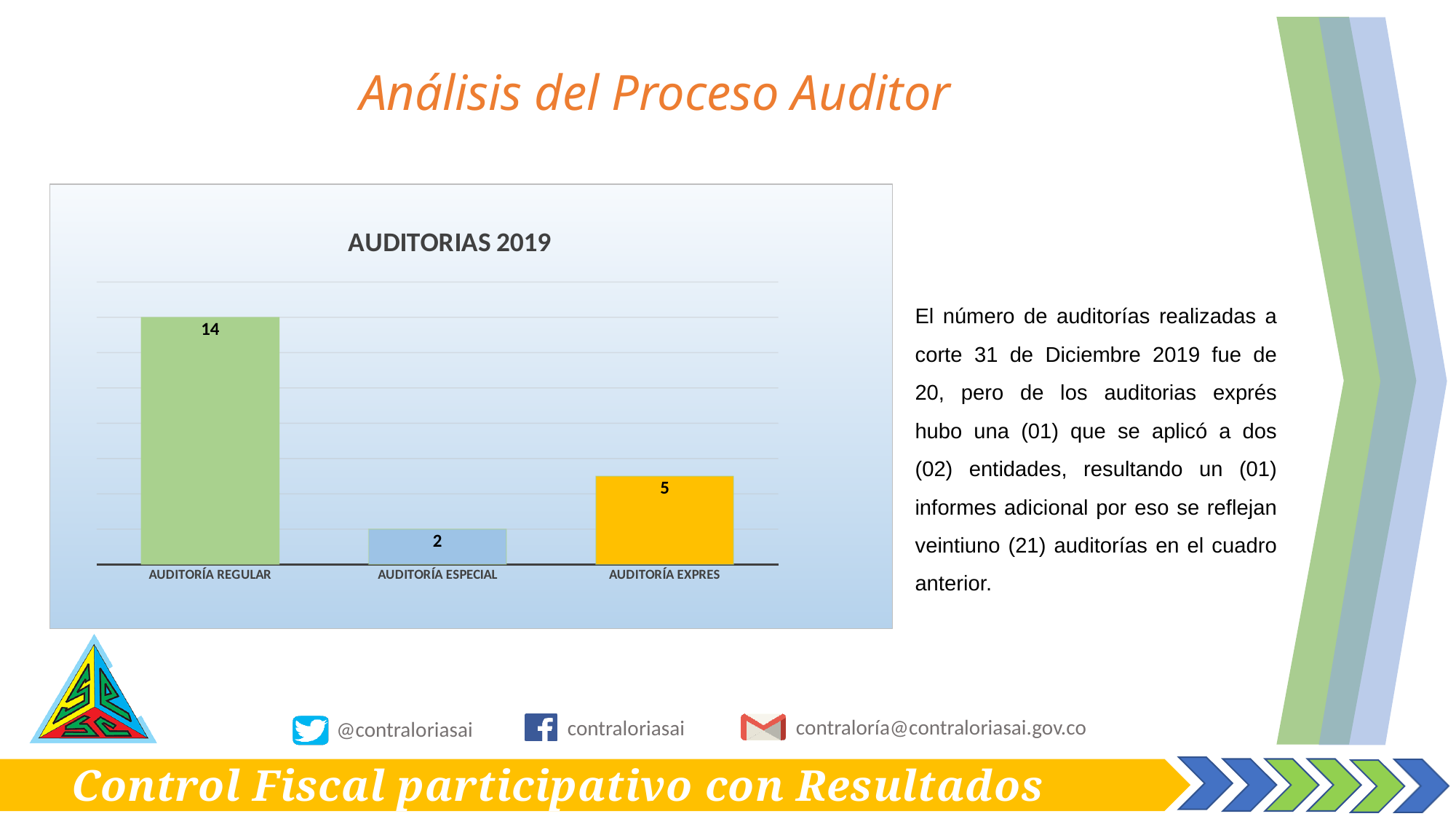
What is the difference between the values for AUDITORÍA EXPRES and AUDITORÍA ESPECIAL? 3 How many categories are shown in the chart? 3 Which is larger, the value for AUDITORÍA EXPRES or AUDITORÍA ESPECIAL? AUDITORÍA EXPRES What kind of chart is shown on the slide? bar chart What is the difference between the values for AUDITORÍA REGULAR and AUDITORÍA EXPRES? 9 What colour is the bar for AUDITORÍA EXPRES? yellow What is the value for AUDITORÍA REGULAR? 14 What is the value for AUDITORÍA EXPRES? 5 What is the title of the chart? AUDITORIAS 2019 Which category has the lowest value? AUDITORÍA ESPECIAL Which category has the highest value? AUDITORÍA REGULAR What is the value for AUDITORÍA ESPECIAL? 2